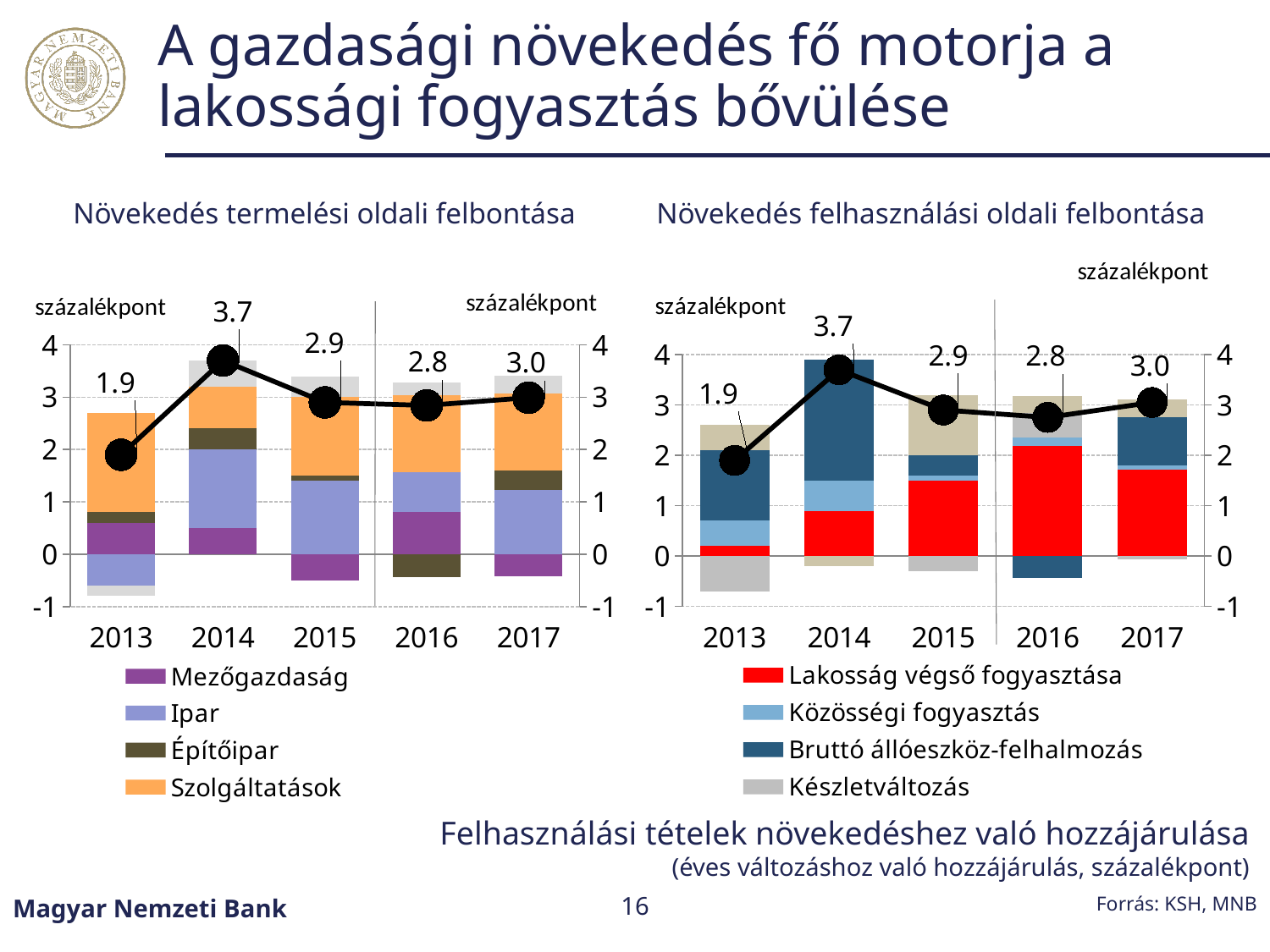
How many years are shown on the x axis of the right chart? 5 In the left chart, what is the difference between the labelled growth values for 2014 and 2013? 1.8 How many series does the legend of the left chart list? 4 In the right chart, which year has the larger labelled growth value, 2015 or 2016? 2015 Which legend entry in the right chart is shown in red? Lakosság végső fogyasztása In the left chart, does the labelled growth value rise or fall from 2013 to 2014? rise In the left chart (Növekedés termelési oldali felbontása), what is the labelled growth value for 2014? 3.7 What kind of chart is the right chart (Növekedés felhasználási oldali felbontása)? Stacked bar chart with a line In the left chart, which year has the highest labelled growth value? 2014 In the right chart (Növekedés felhasználási oldali felbontása), what is the labelled growth value for 2017? 3.0 In the left chart, is the labelled growth value for 2013 greater or less than 2? less In the right chart, which year has the lowest labelled growth value? 2013